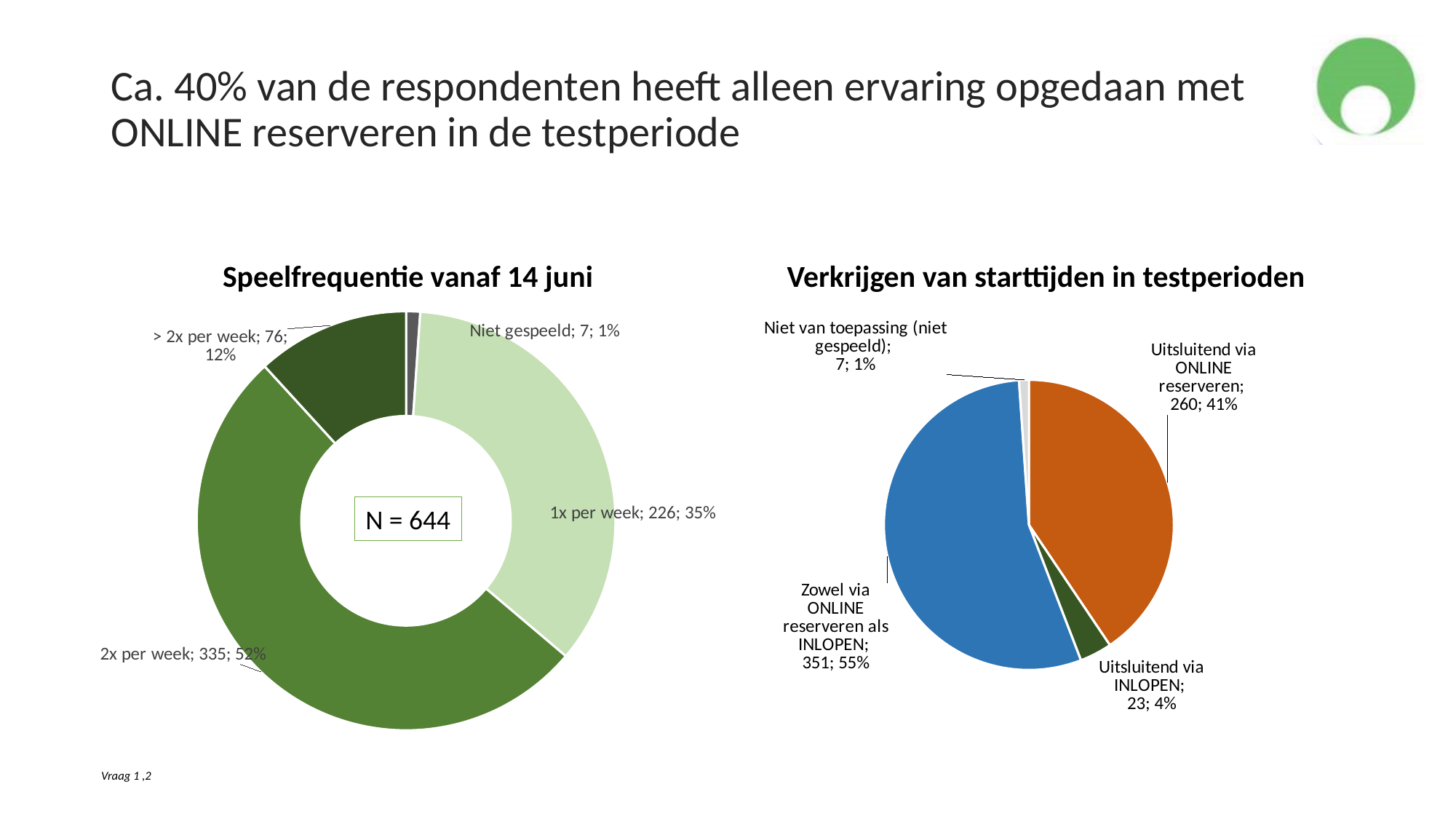
In the 'Speelfrequentie vanaf 14 juni' chart, which category has the smallest share? Niet gespeeld In the 'Speelfrequentie vanaf 14 juni' chart, what is the difference in respondents between 2x per week and 1x per week? 109 What is the N value shown in the centre of the 'Speelfrequentie vanaf 14 juni' chart? N = 644 In the 'Verkrijgen van starttijden in testperioden' chart, how many respondents used exclusively ONLINE reserveren? 260 In the 'Speelfrequentie vanaf 14 juni' chart, what share of respondents play 1x per week? 35% In the 'Speelfrequentie vanaf 14 juni' chart, which category has the largest share? 2x per week In the 'Verkrijgen van starttijden in testperioden' chart, what share of respondents used both ONLINE reserveren and INLOPEN? 55% In the 'Speelfrequentie vanaf 14 juni' chart, how many categories are shown? 4 In the 'Speelfrequentie vanaf 14 juni' chart, how many respondents play 2x per week? 335 In the 'Verkrijgen van starttijden in testperioden' chart, which is larger: Uitsluitend via INLOPEN or Uitsluitend via ONLINE reserveren? Uitsluitend via ONLINE reserveren What type of chart is 'Verkrijgen van starttijden in testperioden'? Pie chart In the 'Verkrijgen van starttijden in testperioden' chart, which category has the largest share? Zowel via ONLINE reserveren als INLOPEN